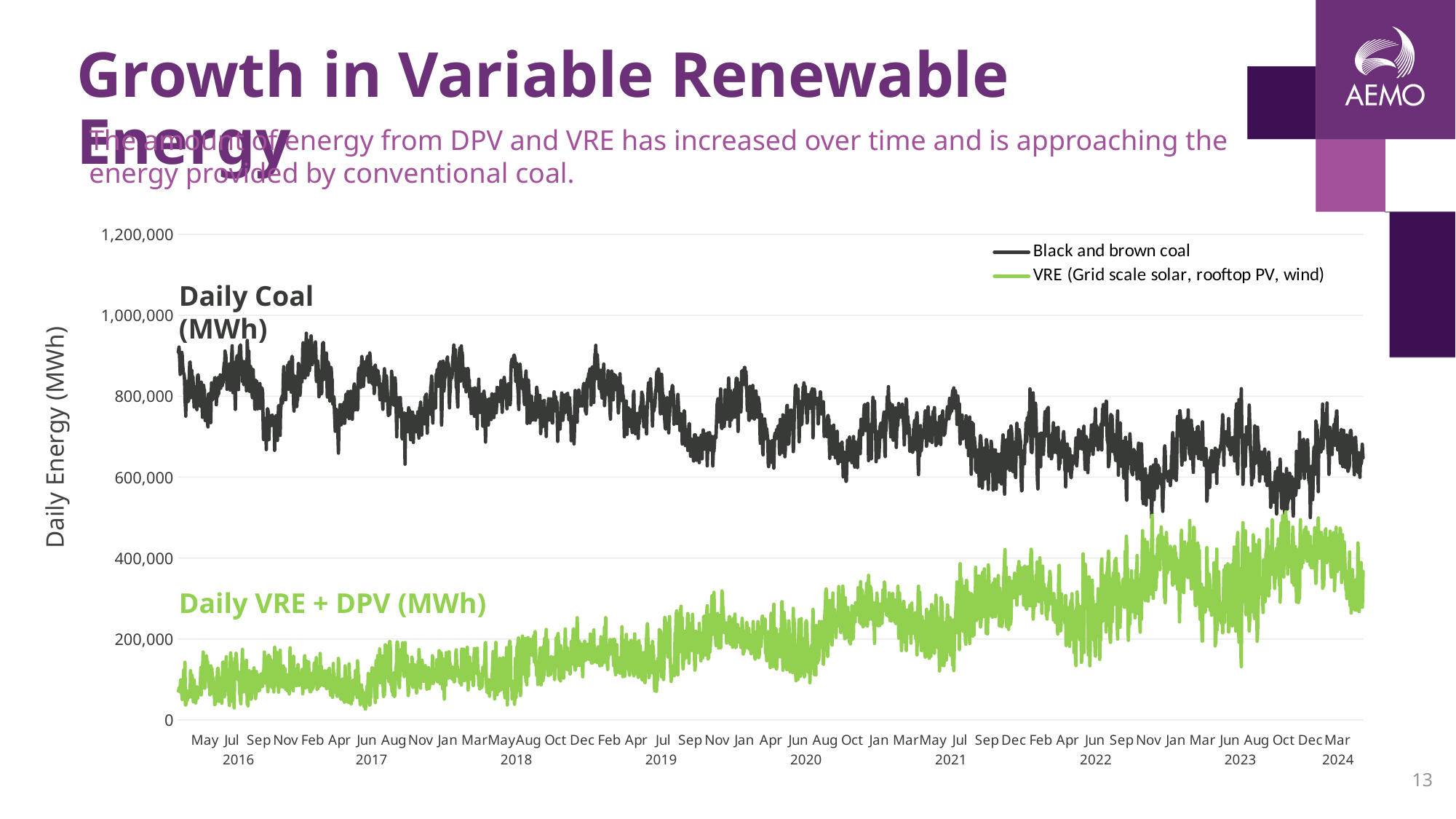
Does the VRE (Grid scale solar, rooftop PV, wind) series rise or fall from 2016 to 2024? Rise Which series has higher values throughout the chart, Black and brown coal or VRE? Black and brown coal How many series does the chart legend list? 2 What is the highest value shown on the y axis? 1,200,000 What is the label of the y axis? Daily Energy (MWh) Is the value for VRE in early 2024 greater or less than 200,000? greater Is the value for VRE in 2016 greater or less than 200,000? less What kind of chart is shown on the slide? Line chart Does the Black and brown coal series rise or fall from 2016 to 2024? Fall Is the value for Black and brown coal in 2016 greater or less than 600,000? greater Which series is drawn in green according to the legend? VRE (Grid scale solar, rooftop PV, wind)